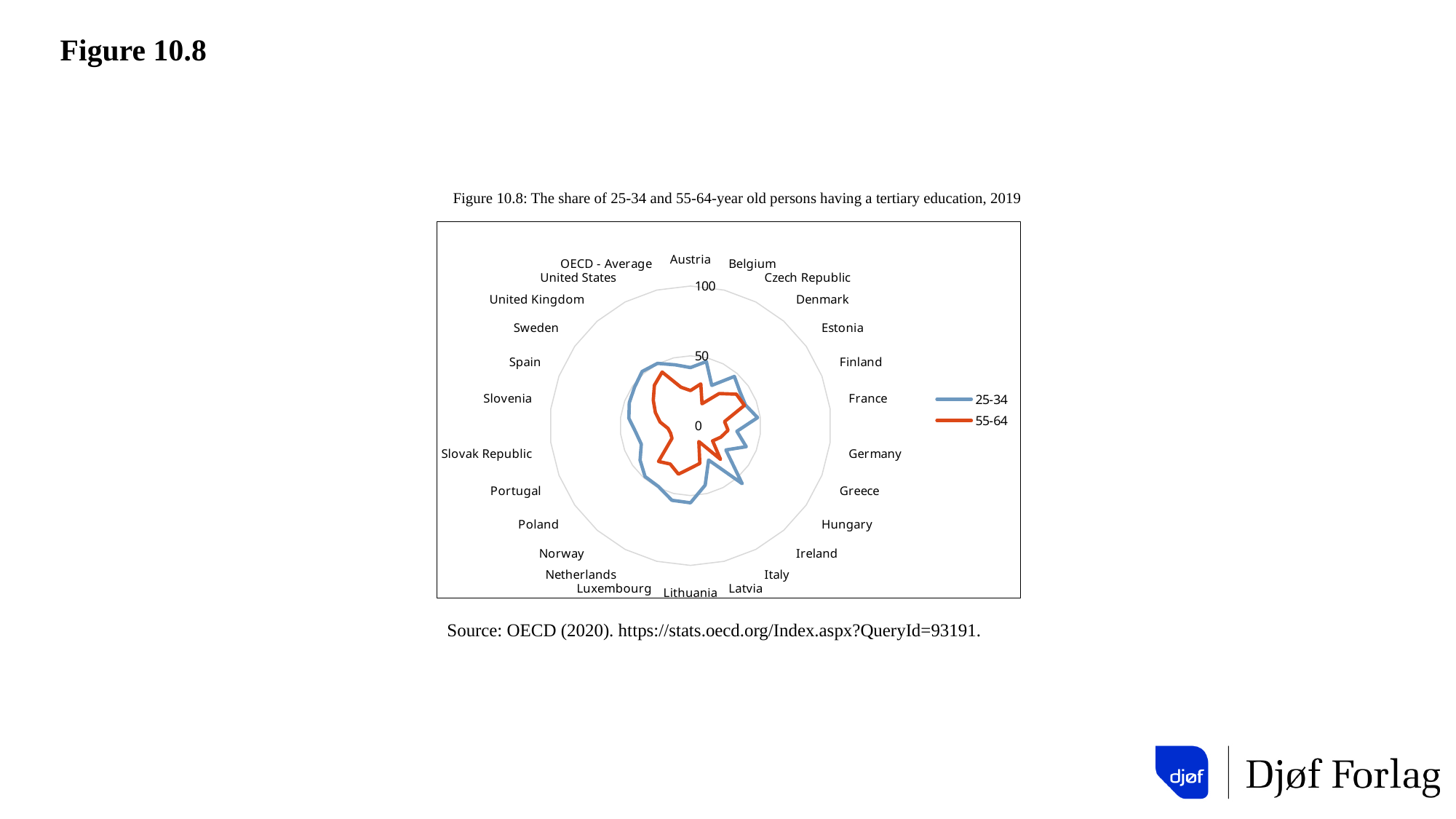
Is the value for Italy in the 55-64 series greater or less than 50? less How many series does the legend list? 2 What are the two series named in the legend? 25-34 and 55-64 How many countries/categories are plotted around the radar chart? 26 Is the value for Ireland in the 25-34 series greater or less than 100? less Is the value for Germany in the 55-64 series greater or less than 50? less What is the title of the chart? Figure 10.8: The share of 25-34 and 55-64-year old persons having a tertiary education, 2019 For Ireland, which series has the larger value, 25-34 or 55-64? 25-34 For Poland, which series has the larger value, 25-34 or 55-64? 25-34 What kind of chart is shown on the slide? Radar chart For Lithuania, which series has the larger value, 25-34 or 55-64? 25-34